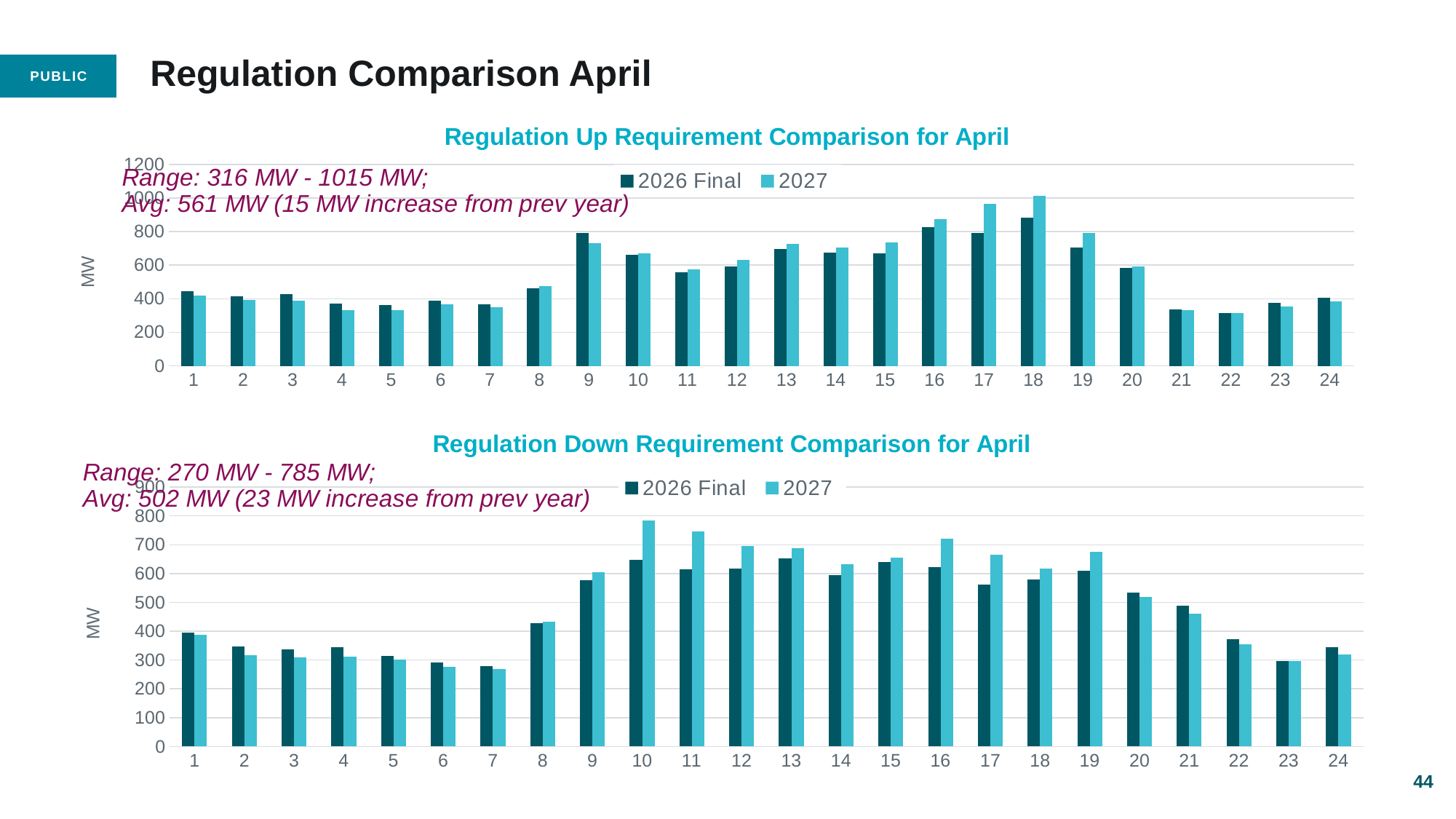
In the Regulation Up Requirement Comparison for April chart, at which hour is the 2027 value highest? 18 In the Regulation Up Requirement Comparison for April chart, which is larger at hour 9: 2026 Final or 2027? 2026 Final In the Regulation Down Requirement Comparison for April chart, is the 2027 value for hour 10 greater or less than 700? greater In the Regulation Up Requirement Comparison for April chart, is the 2027 value for hour 17 greater or less than 800? greater What kind of chart is the Regulation Down Requirement Comparison for April? Bar chart What is the y-axis label of the Regulation Down Requirement Comparison for April chart? MW In the Regulation Down Requirement Comparison for April chart, at which hour is the 2027 value highest? 10 In the Regulation Up Requirement Comparison for April chart, how many series does the legend list? 2 In the Regulation Up Requirement Comparison for April chart, how many hours are shown on the x axis? 24 In the Regulation Down Requirement Comparison for April chart, which is larger at hour 17: 2026 Final or 2027? 2027 In the Regulation Down Requirement Comparison for April chart, at which hour is the 2027 value lowest? 7 In the Regulation Up Requirement Comparison for April chart, is the 2026 Final value for hour 22 greater or less than 400? less